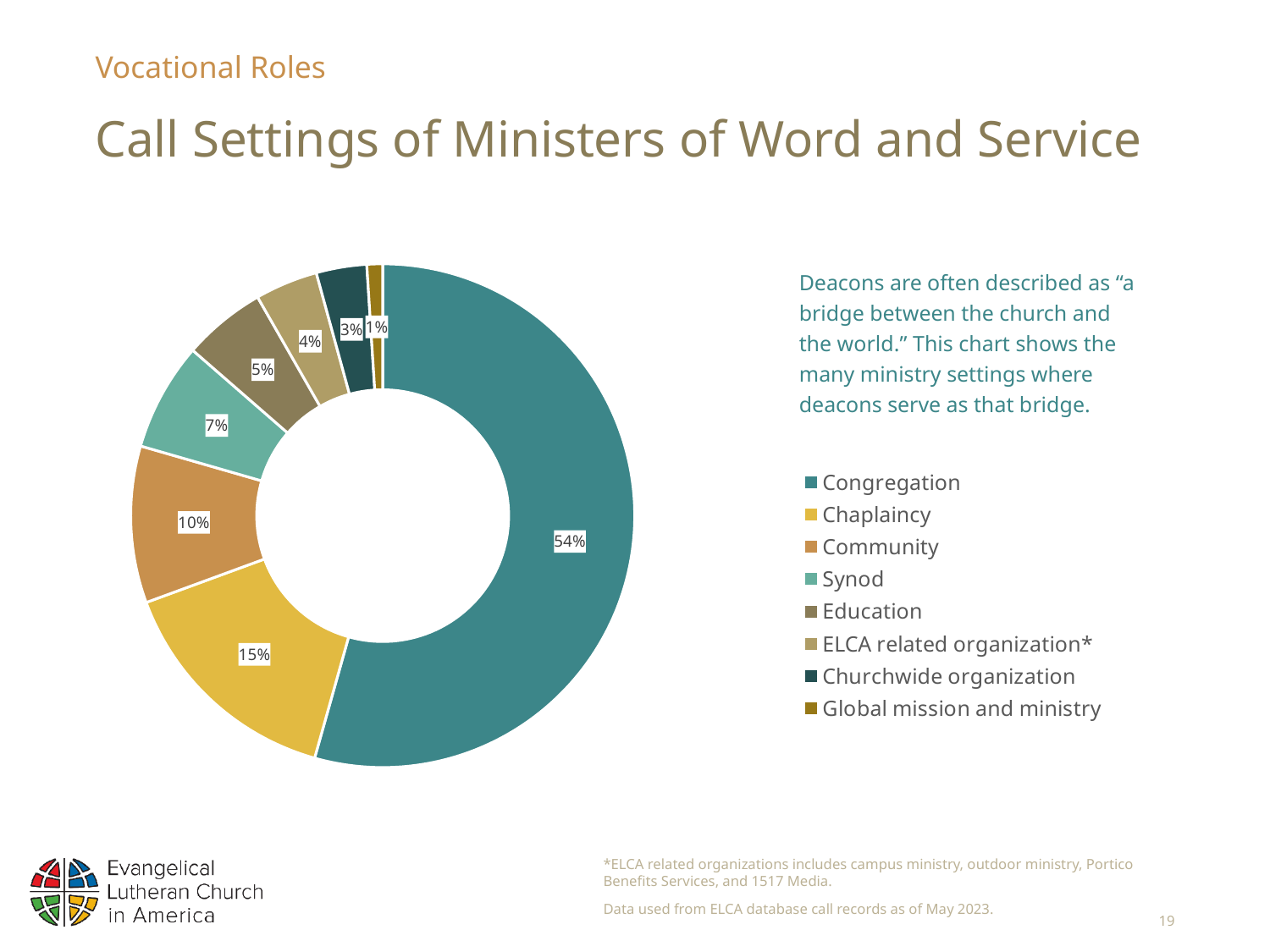
What percentage of ministers of Word and Service are called to a Congregation setting? 54% What is the title of the chart? Call Settings of Ministers of Word and Service What percentage is shown for Synod? 7% Which call setting has the smallest share? Global mission and ministry What percentage is shown for Churchwide organization? 3% Which is larger, the share for Education or the share for ELCA related organization*? Education What share of the chart is Chaplaincy? 15% How many percentage points larger is Congregation than Chaplaincy? 39 Which call setting has the largest share? Congregation What percentage is shown for Community? 10% What kind of chart is shown on the slide? doughnut chart How many call settings does the legend list? 8